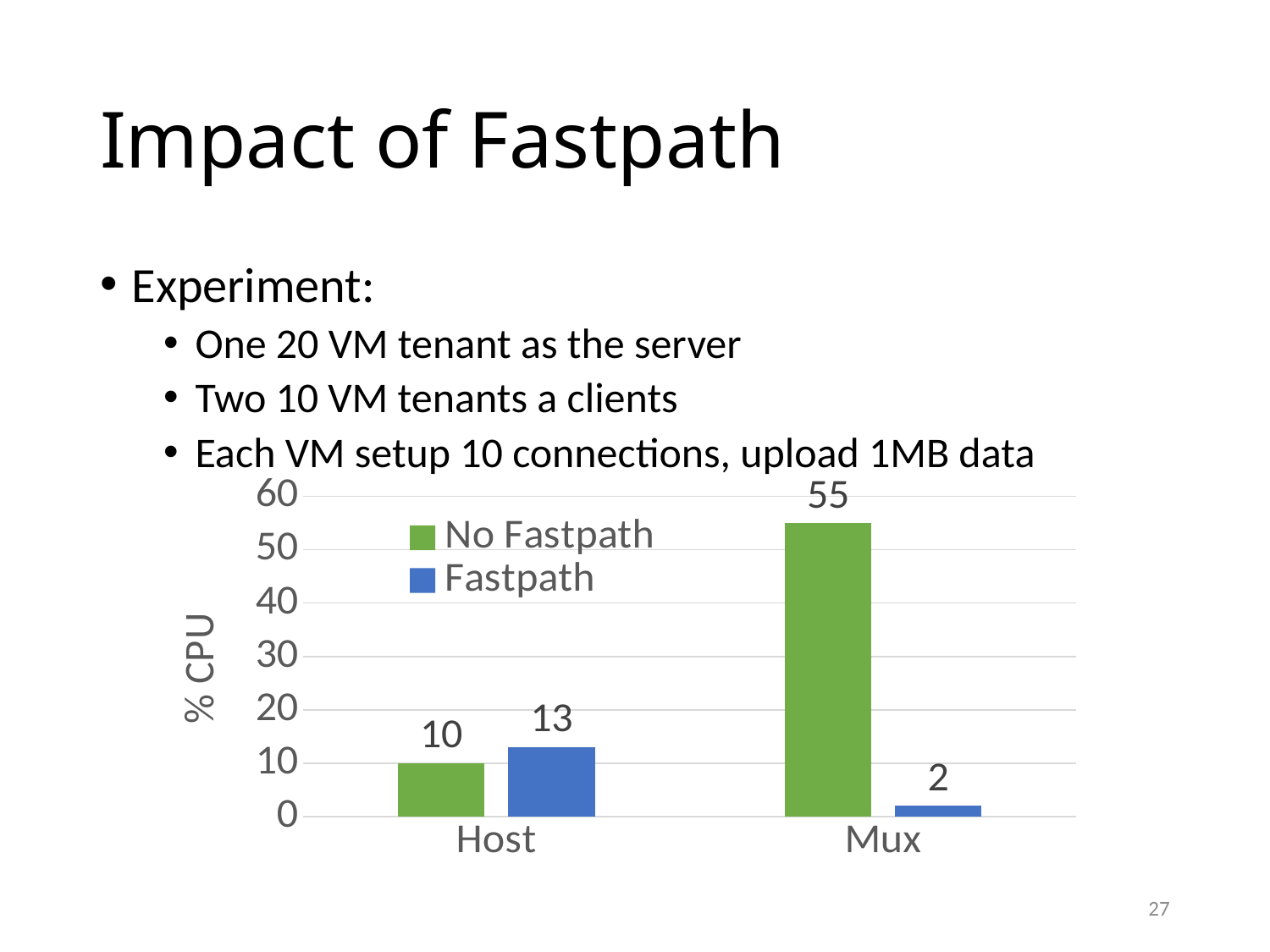
What is the % CPU value for No Fastpath on Mux? 55 What is the % CPU value for No Fastpath on Host? 10 What kind of chart is shown on the slide? bar chart What is the difference in % CPU between No Fastpath and Fastpath on Mux? 53 Which bar has the highest % CPU value? No Fastpath on Mux How many categories are shown on the x axis? 2 What is the % CPU value for Fastpath on Host? 13 Is the value for No Fastpath on Mux greater or less than 50? greater Which bar has the lowest % CPU value? Fastpath on Mux How many series does the legend list? 2 On Host, which is larger: No Fastpath or Fastpath? Fastpath What is the % CPU value for Fastpath on Mux? 2